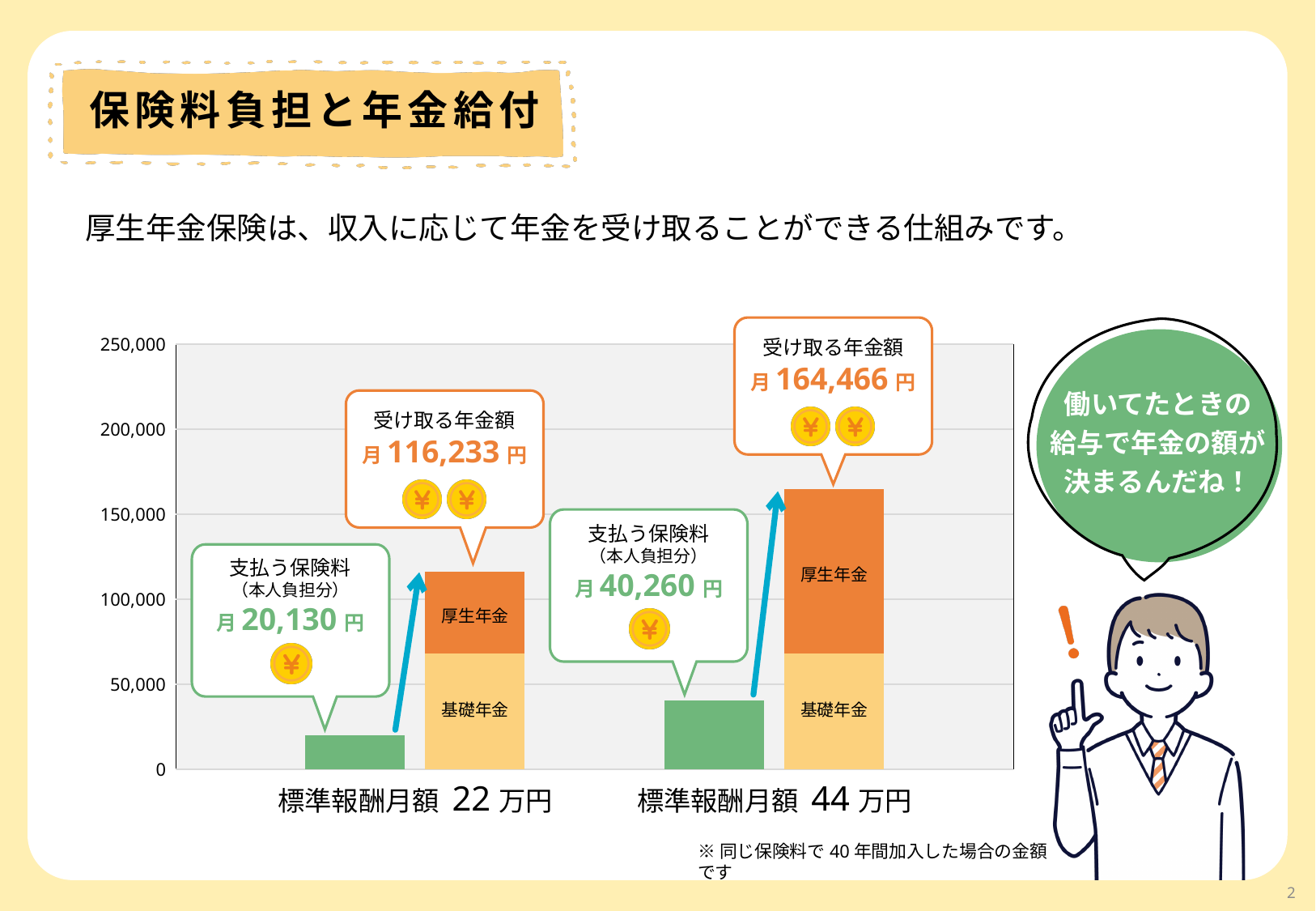
How many 標準報酬月額 categories are shown on the x axis of the chart? 2 What is the monthly insurance premium (支払う保険料, 本人負担分) shown for 標準報酬月額 22万円? 月20,130円 What is the difference between the monthly premiums for 標準報酬月額 44万円 and 標準報酬月額 22万円? 20,130円 What is the monthly insurance premium (支払う保険料, 本人負担分) shown for 標準報酬月額 44万円? 月40,260円 Which category has the larger monthly pension amount, 標準報酬月額 22万円 or 標準報酬月額 44万円? 標準報酬月額 44万円 What is the monthly pension amount (受け取る年金額) shown for 標準報酬月額 44万円? 月164,466円 Is the 基礎年金 segment of the stacked bar for 標準報酬月額 22万円 greater or less than 50,000? greater What is the monthly pension amount (受け取る年金額) shown for 標準報酬月額 22万円? 月116,233円 What kind of chart is shown on the slide? Bar chart Is the 厚生年金 segment of the stacked bar for 標準報酬月額 44万円 greater or less than 50,000? greater What are the two segments that make up each stacked pension bar? 基礎年金 and 厚生年金 How much larger is the monthly pension for 標準報酬月額 44万円 than for 標準報酬月額 22万円? 48,233円